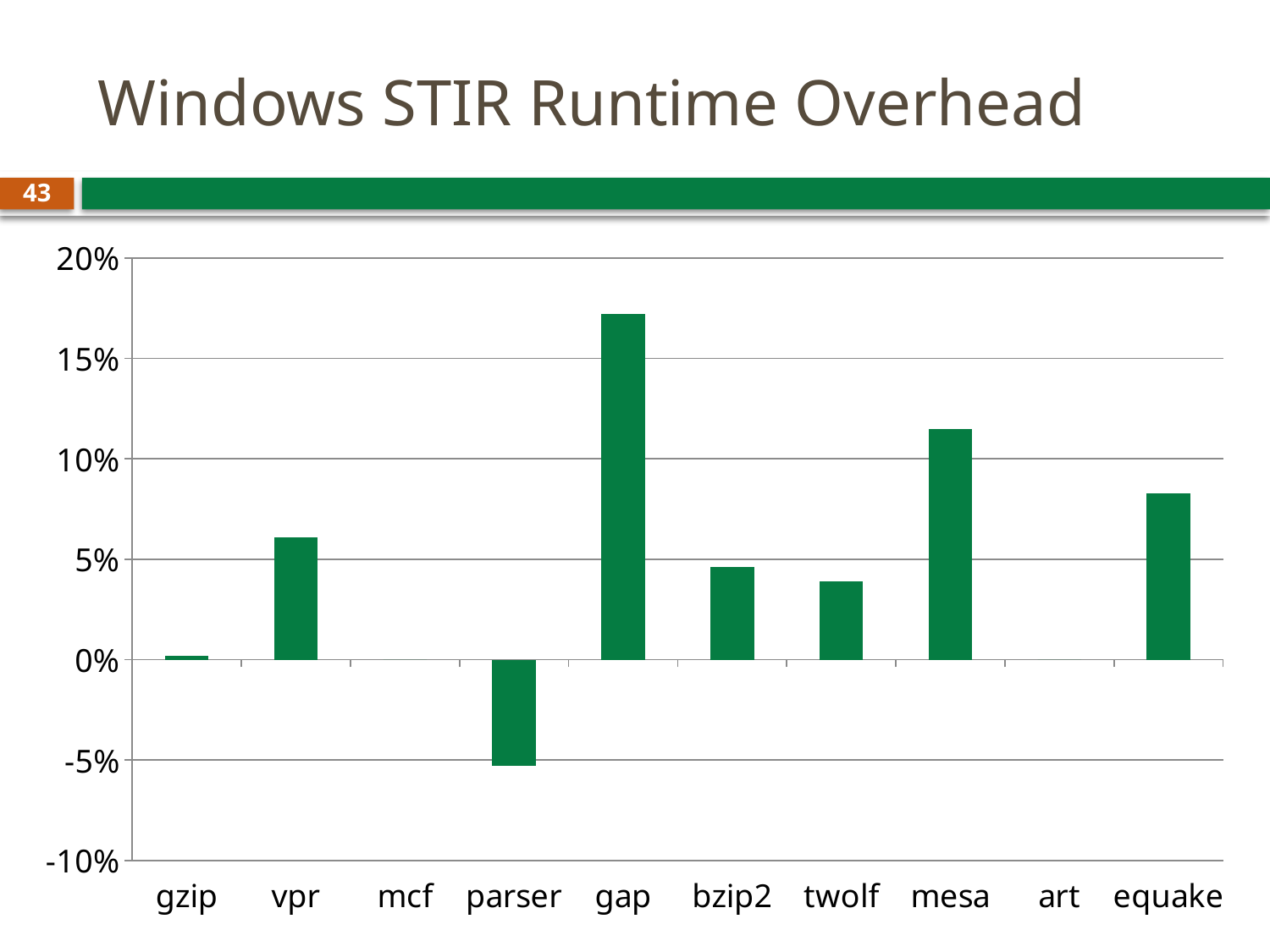
Which benchmark has the highest runtime overhead? gap Which benchmark has the lowest runtime overhead? parser What is the title of the slide containing the chart? Windows STIR Runtime Overhead Is the value for gap greater or less than 15%? greater Which has the larger runtime overhead, vpr or twolf? vpr Is the value for equake greater or less than 10%? less Is the value for parser greater or less than 0%? less Which has the larger runtime overhead, mesa or equake? mesa What kind of chart is shown on the slide? bar chart How many benchmark categories are shown on the x axis? 10